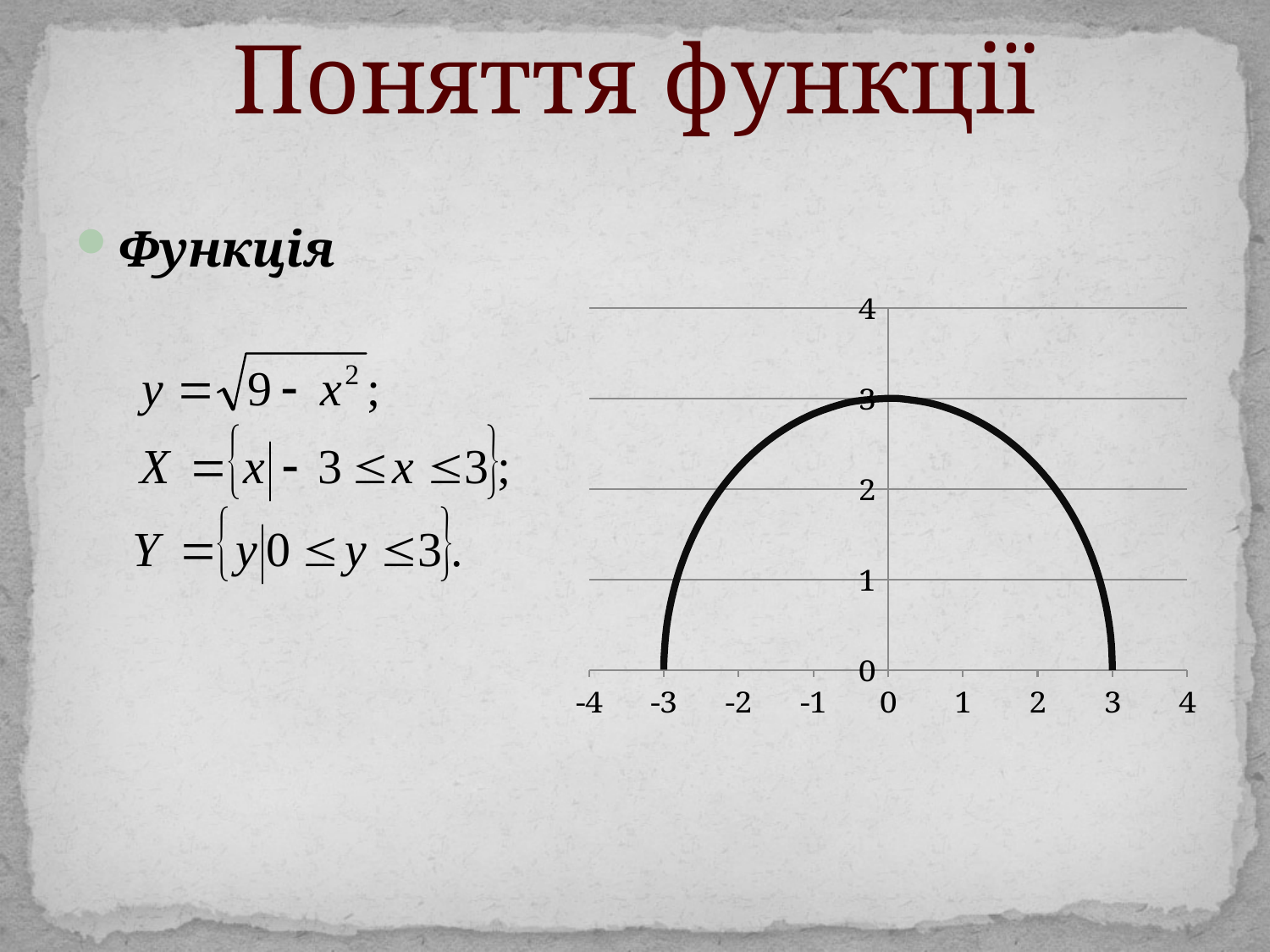
Which is larger, the value of the curve at x = 0 or at x = 2? x = 0 Is the value of the curve at x = 2 greater or less than 2? greater What is the value of y on the curve at x = -3? 0 At which value of x does the curve reach its highest point? 0 Is the value of the curve at x = 1 greater or less than 3? less Does the curve rise or fall as x goes from -3 to 0? rise What is the value of y on the curve at x = 3? 0 What is the highest tick label shown on the y axis? 4 Does the curve rise or fall as x goes from 0 to 3? fall What is the difference between the value of the curve at x = 0 and at x = 3? 3 What kind of chart is shown on the slide? line chart What is the value of y on the curve at x = 0? 3